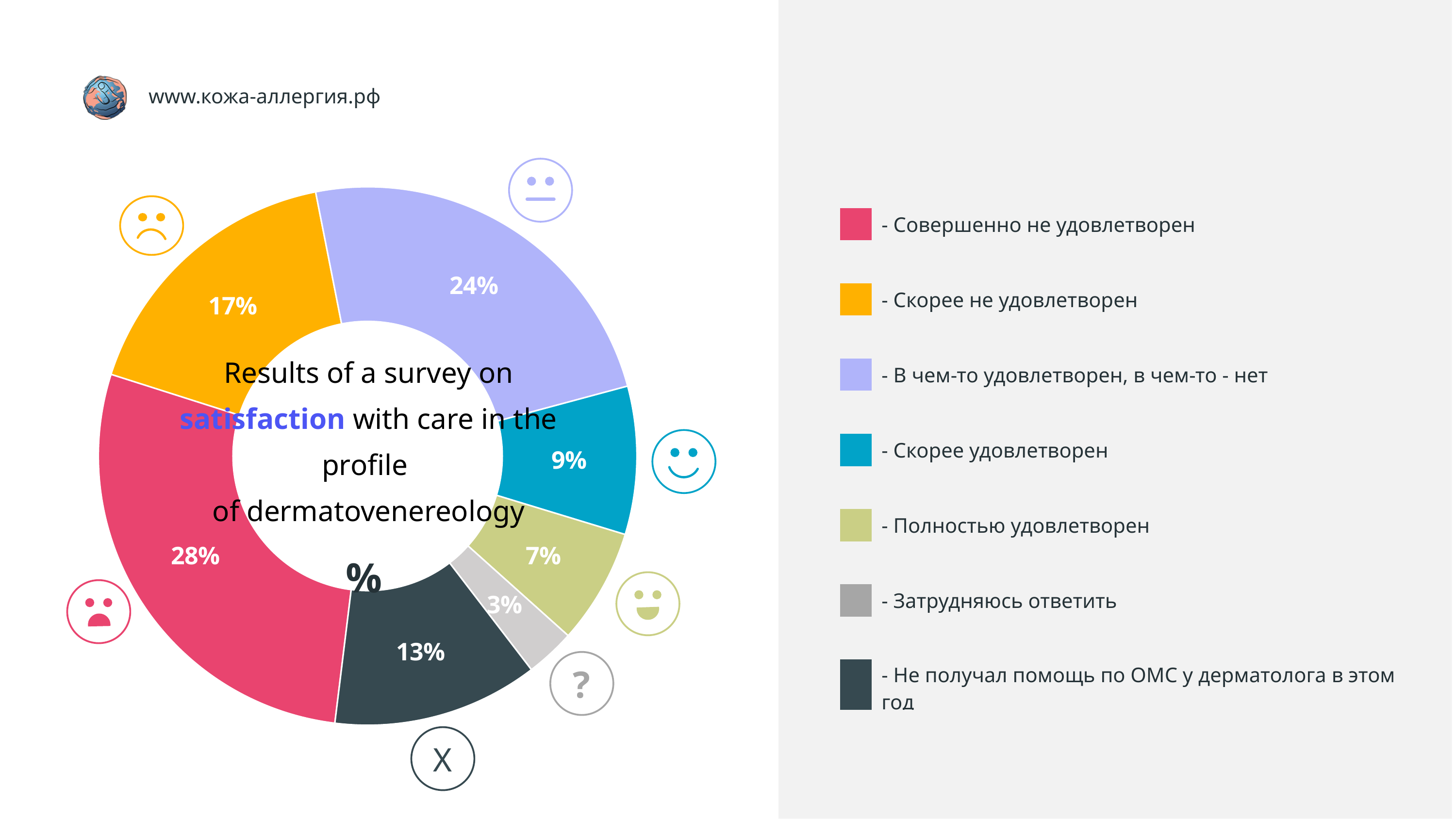
What share of respondents answered "Скорее удовлетворен"? 9% How many categories does the legend list? 7 Which is larger: the share for "Скорее удовлетворен" or the share for "Полностью удовлетворен"? Скорее удовлетворен What share of respondents answered "В чем-то удовлетворен, в чем-то - нет"? 24% What share of respondents answered "Совершенно не удовлетворен"? 28% What share of respondents answered "Затрудняюсь ответить"? 3% What share of respondents answered "Скорее не удовлетворен"? 17% Which response category has the largest share of the pie? Совершенно не удовлетворен What share of respondents answered "Полностью удовлетворен"? 7% Which response category has the smallest share of the pie? Затрудняюсь ответить What is the difference in percentage points between "Совершенно не удовлетворен" and "Скорее не удовлетворен"? 11 What type of chart is shown on the slide? Pie chart (donut)